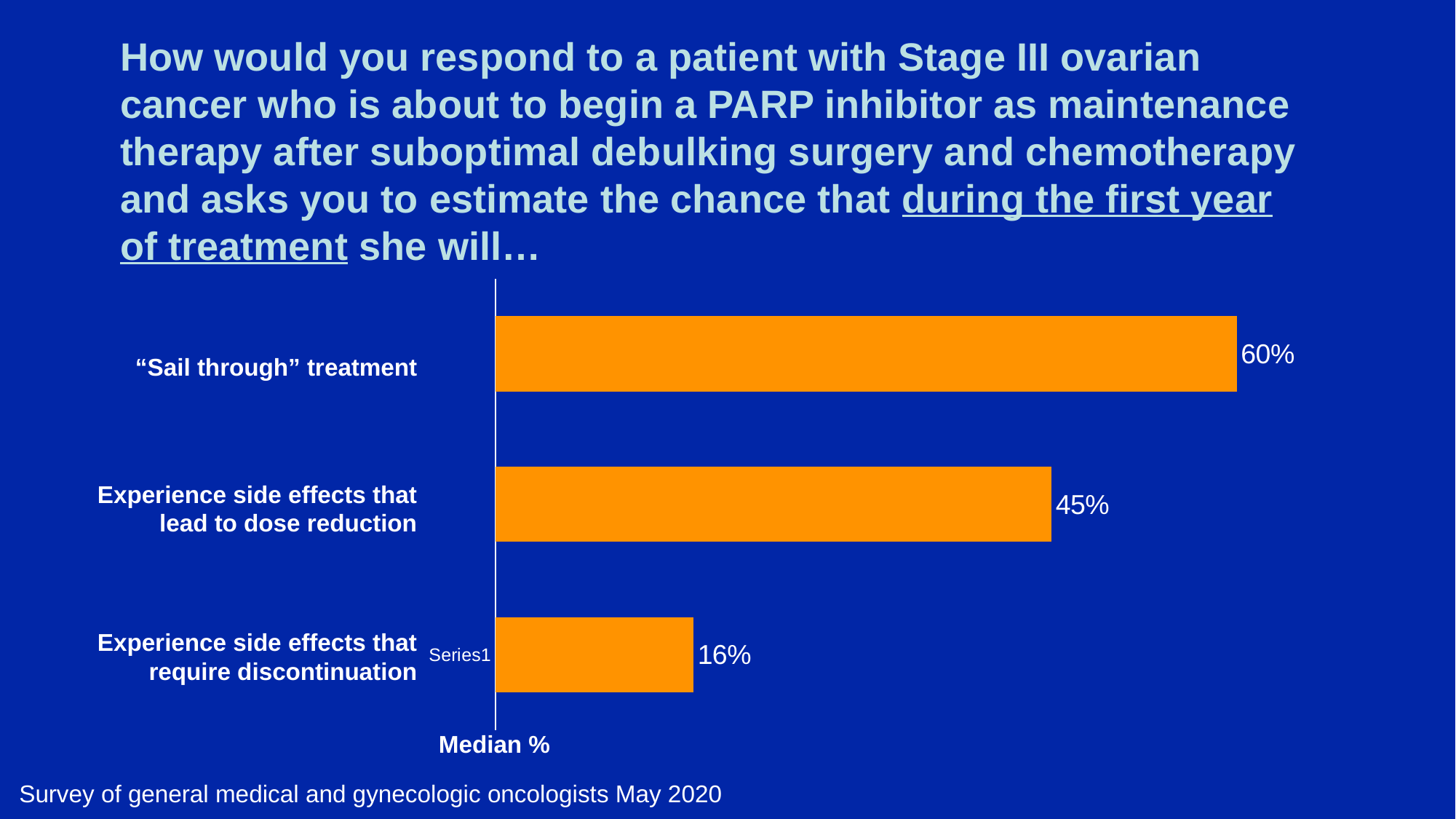
What is the median % for experiencing side effects that lead to dose reduction? 45% What colour are the bars in the chart? Orange What is the label shown beneath the chart's axis? Median % What is the median % for experiencing side effects that require discontinuation? 16% Which category has the highest median %? "Sail through" treatment What kind of chart is shown on the slide? Bar chart How many categories are shown in the chart? 3 Which category has the lowest median %? Experience side effects that require discontinuation What is the median % for "Sail through" treatment? 60% What is the difference between the median % for side effects that lead to dose reduction and side effects that require discontinuation? 29% What is the difference between the median % for "Sail through" treatment and for side effects that lead to dose reduction? 15% Which is larger: the median % for side effects that lead to dose reduction or for side effects that require discontinuation? Experience side effects that lead to dose reduction